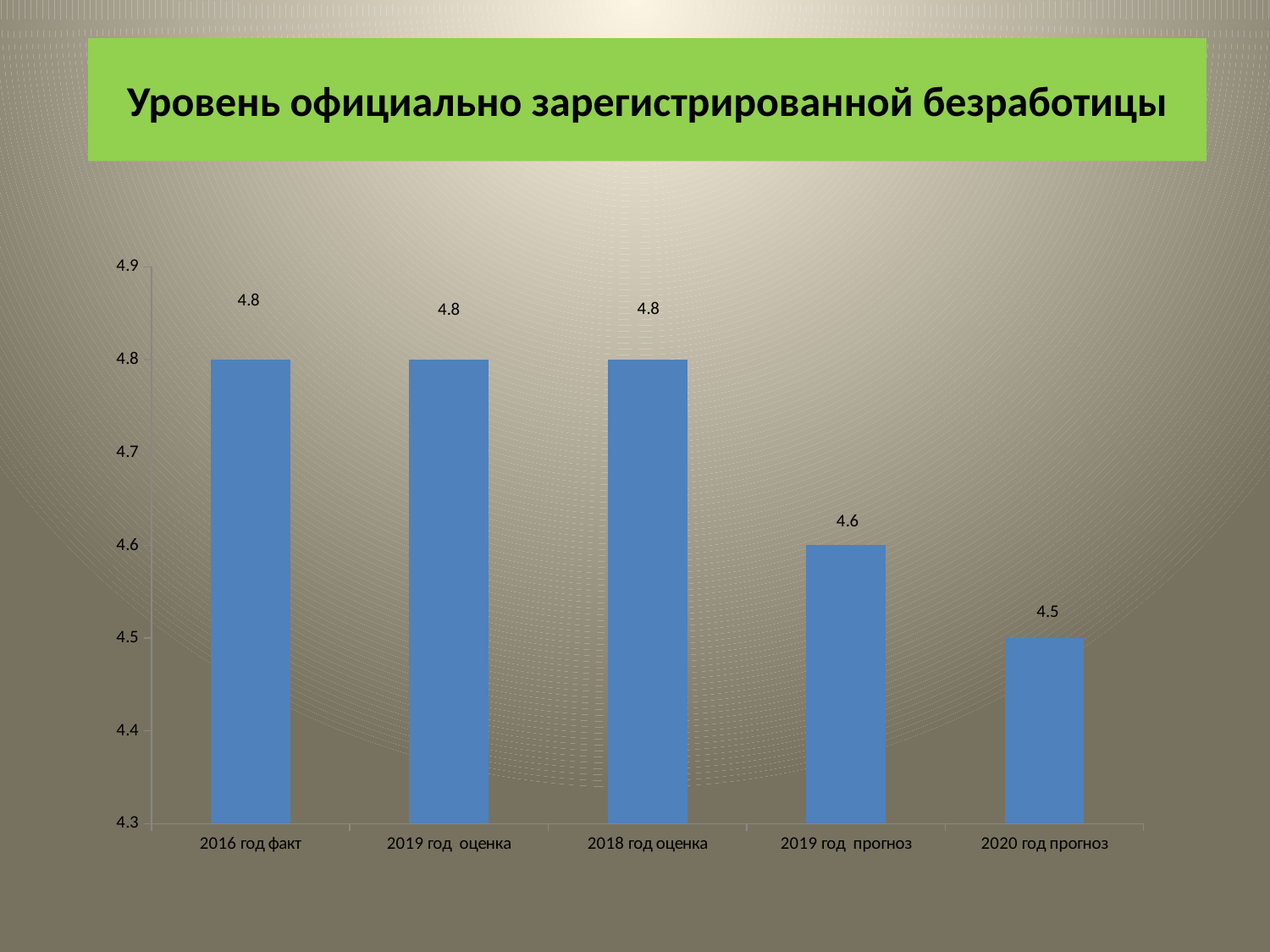
What is the difference between the values for 2016 год факт and 2020 год прогноз? 0.3 What kind of chart is shown on the slide? bar chart What is the difference between the values for 2019 год прогноз and 2020 год прогноз? 0.1 Which is larger, the value for 2018 год оценка or the value for 2019 год прогноз? 2018 год оценка What is the value for 2016 год факт? 4.8 Is the value for 2019 год прогноз greater or less than 4.7? less What is the title of the chart? Уровень официально зарегистрированной безработицы How many categories are shown on the x axis? 5 Which category has the lowest value? 2020 год прогноз What is the value for 2020 год прогноз? 4.5 What is the value for 2019 год прогноз? 4.6 What is the value for 2018 год оценка? 4.8